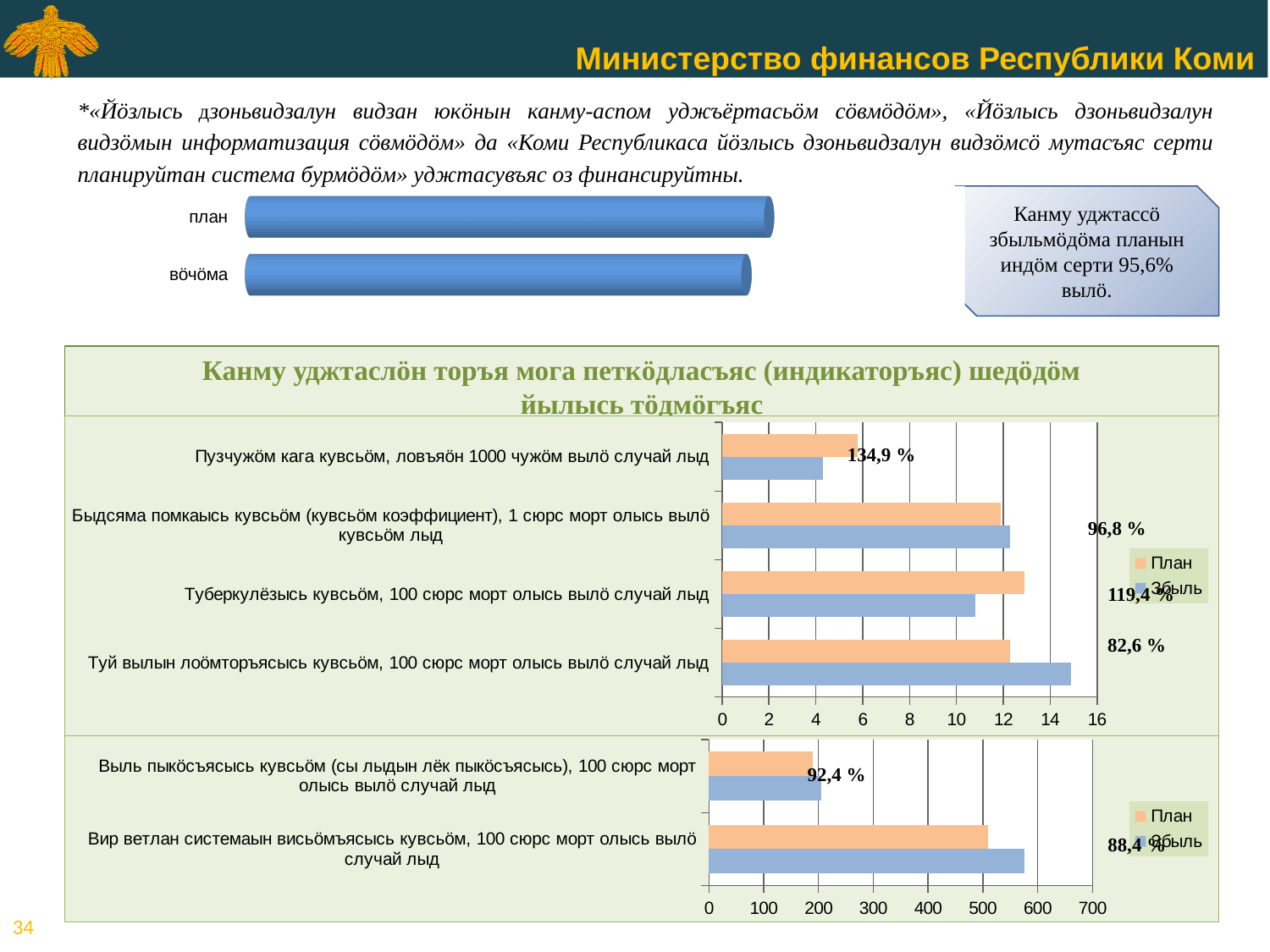
In the middle chart, is the План value for «Пузчужöм кага кувсьöм, ловъяöн 1000 чужöм вылö случай лыд» greater or less than 8? less What kind of chart is the middle chart titled «Канму уджтаслöн торъя мога петкöдласъяс (индикаторъяс) шедöдöм йылысь тöдмöгъяс»? bar chart How many series does the legend of the middle chart list? 2 How many categories are shown in the bottom chart (x axis 0–700)? 2 In the middle chart, which category has the lowest План value? Пузчужöм кага кувсьöм, ловъяöн 1000 чужöм вылö случай лыд In the middle chart, is the Збыль value for «Туй вылын лоöмторъясысь кувсьöм, 100 сюрс морт олысь вылö случай лыд» greater or less than 14? greater In the bottom chart, is the Збыль value for «Вир ветлан системаын висьöмъясысь кувсьöм, 100 сюрс морт олысь вылö случай лыд» greater or less than 500? greater In the bottom chart, which series has the larger value for «Вир ветлан системаын висьöмъясысь кувсьöм, 100 сюрс морт олысь вылö случай лыд», План or Збыль? Збыль In the middle chart, which category has the highest Збыль value? Туй вылын лоöмторъясысь кувсьöм, 100 сюрс морт олысь вылö случай лыд In the middle chart, which series has the larger value for «Туй вылын лоöмторъясысь кувсьöм, 100 сюрс морт олысь вылö случай лыд», План or Збыль? Збыль How many categories are shown in the middle chart (x axis 0–16)? 4